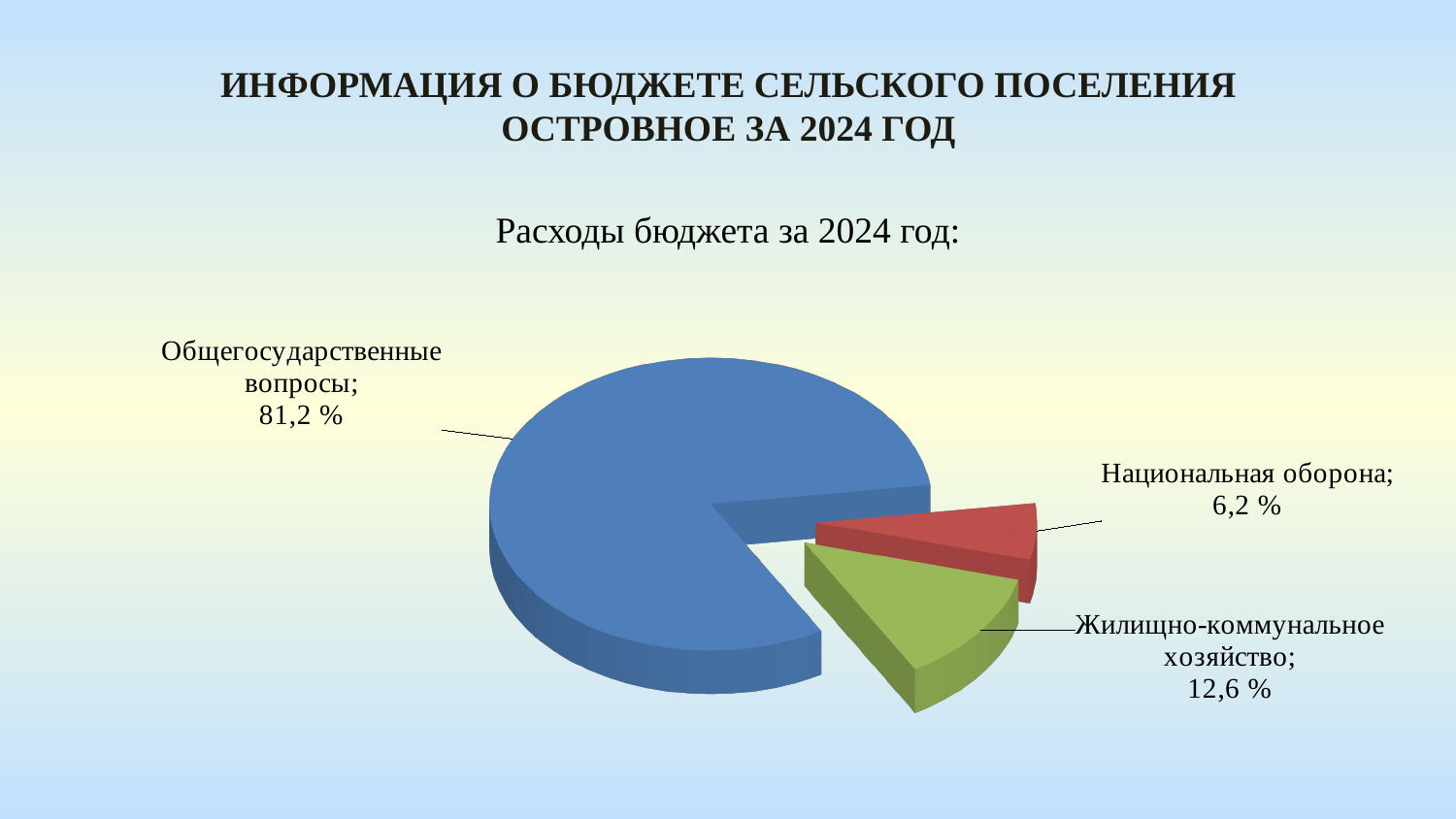
What kind of chart is shown on the slide? Pie chart What share of the pie does Национальная оборона have? 6,2 % What is the difference in percentage points between Жилищно-коммунальное хозяйство and Национальная оборона? 6,4 Which category has the smallest slice of the pie? Национальная оборона How many categories are shown in the pie chart? 3 Which is larger: the share for Жилищно-коммунальное хозяйство or the share for Национальная оборона? Жилищно-коммунальное хозяйство What colour is the slice for Национальная оборона? Red What is the title of the chart? Расходы бюджета за 2024 год: Which category has the largest slice of the pie? Общегосударственные вопросы What share of the pie does Жилищно-коммунальное хозяйство have? 12,6 % What share of the pie does Общегосударственные вопросы have? 81,2 % What is the difference in percentage points between Общегосударственные вопросы and Жилищно-коммунальное хозяйство? 68,6